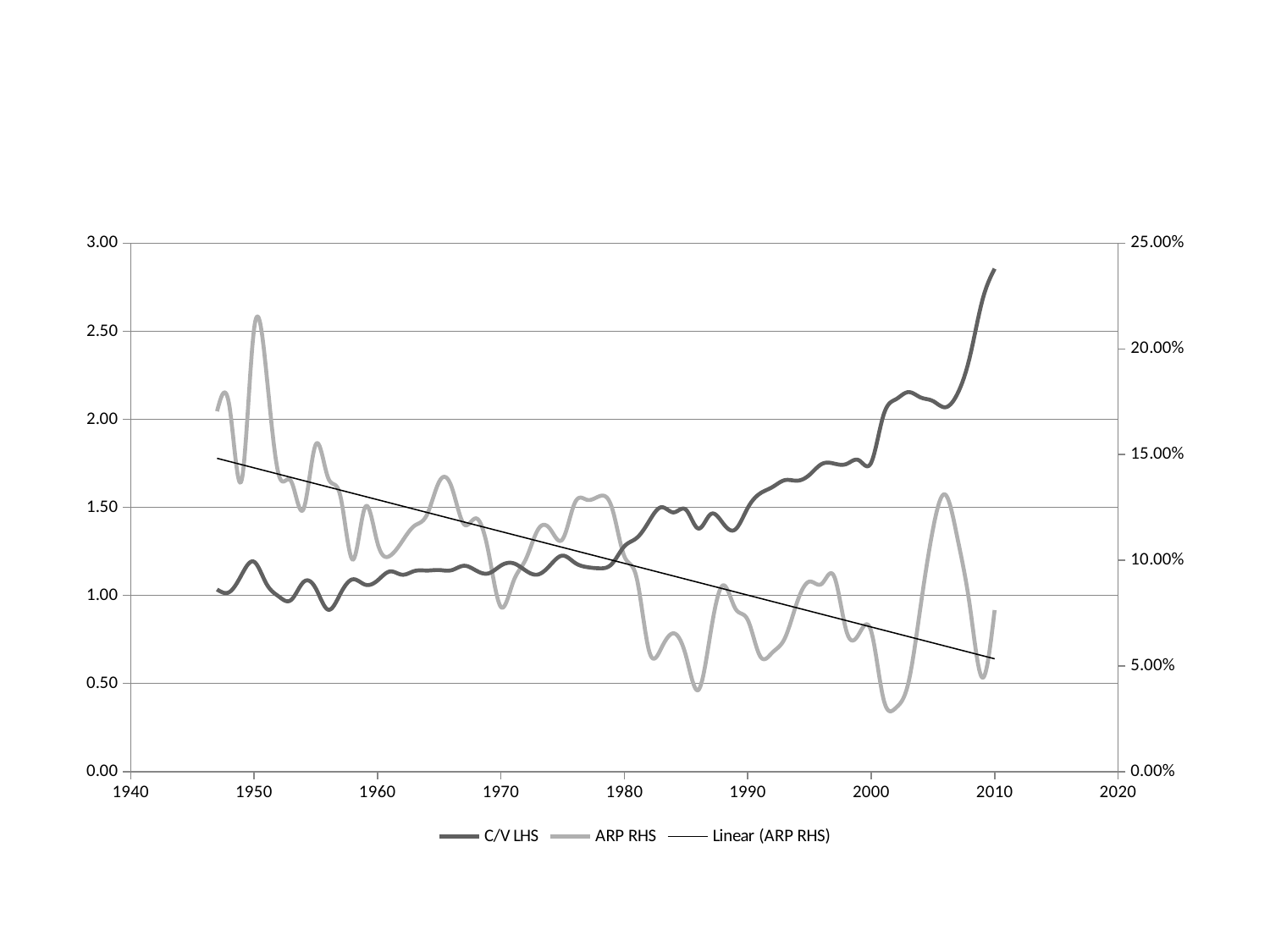
What kind of chart is shown on the slide? Line chart Is the value of C/V LHS in 1950 greater or less than 1.50? less What is the maximum value shown on the right-hand vertical axis? 25.00% Does the Linear (ARP RHS) trendline slope upward or downward across the years? Downward How many entries does the legend list? 3 Does the C/V LHS series generally rise or fall from 1950 to 2010? Rise Is the value of C/V LHS in 2010 greater or less than 2.50? greater Is the Linear (ARP RHS) trendline at 2010 greater or less than 10.00%? less Which is larger, the C/V LHS value in 2010 or the C/V LHS value in 1950? 2010 What are the three entries in the legend? C/V LHS, ARP RHS, Linear (ARP RHS)